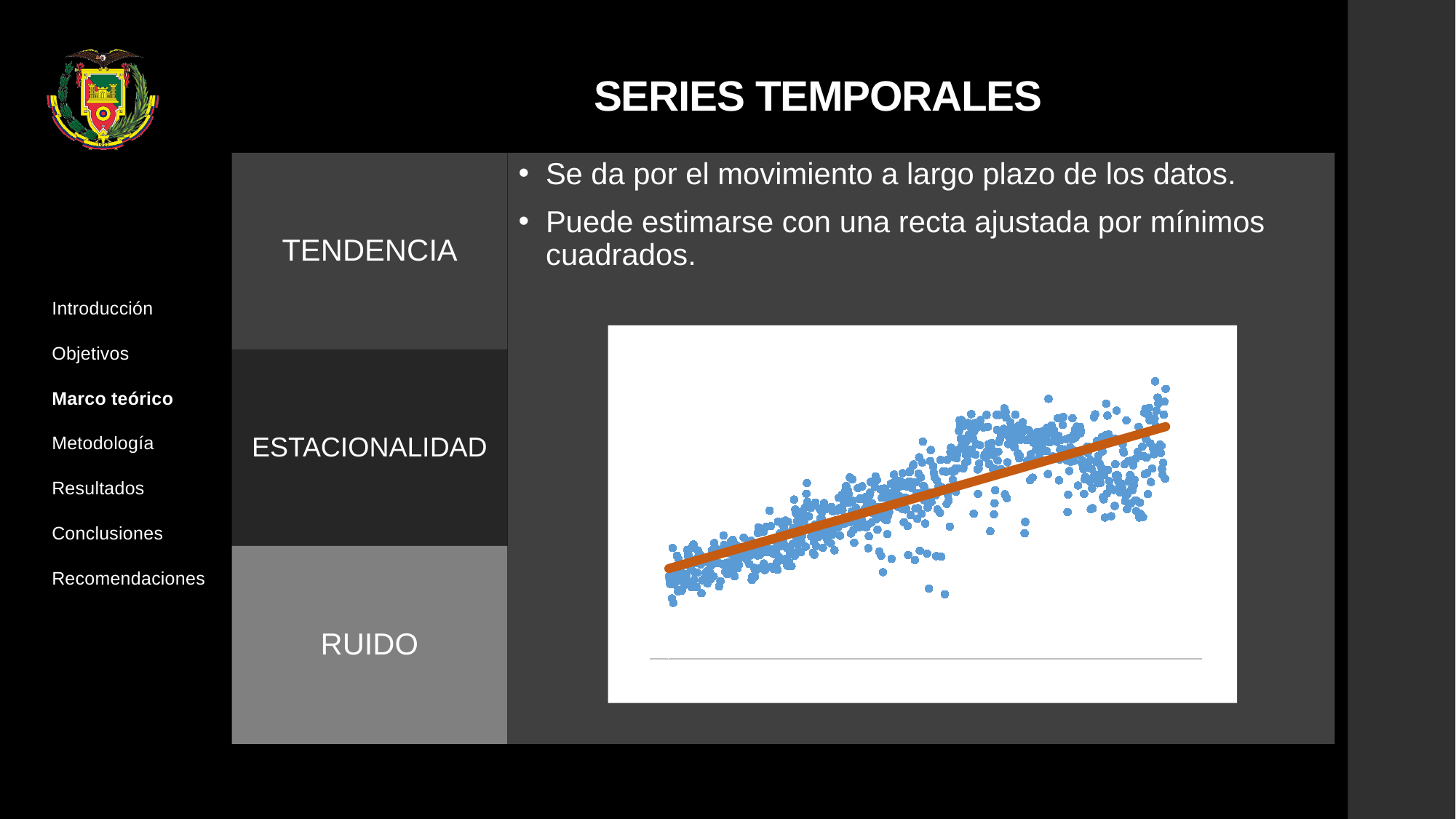
Do the plotted points generally rise or fall from left to right along the x axis? rise What colour is the fitted trend line drawn through the points? orange What kind of chart is shown on the slide? scatter chart Does the fitted straight line in the chart slope upward or downward from left to right? upward What colour are the data points in the chart? blue